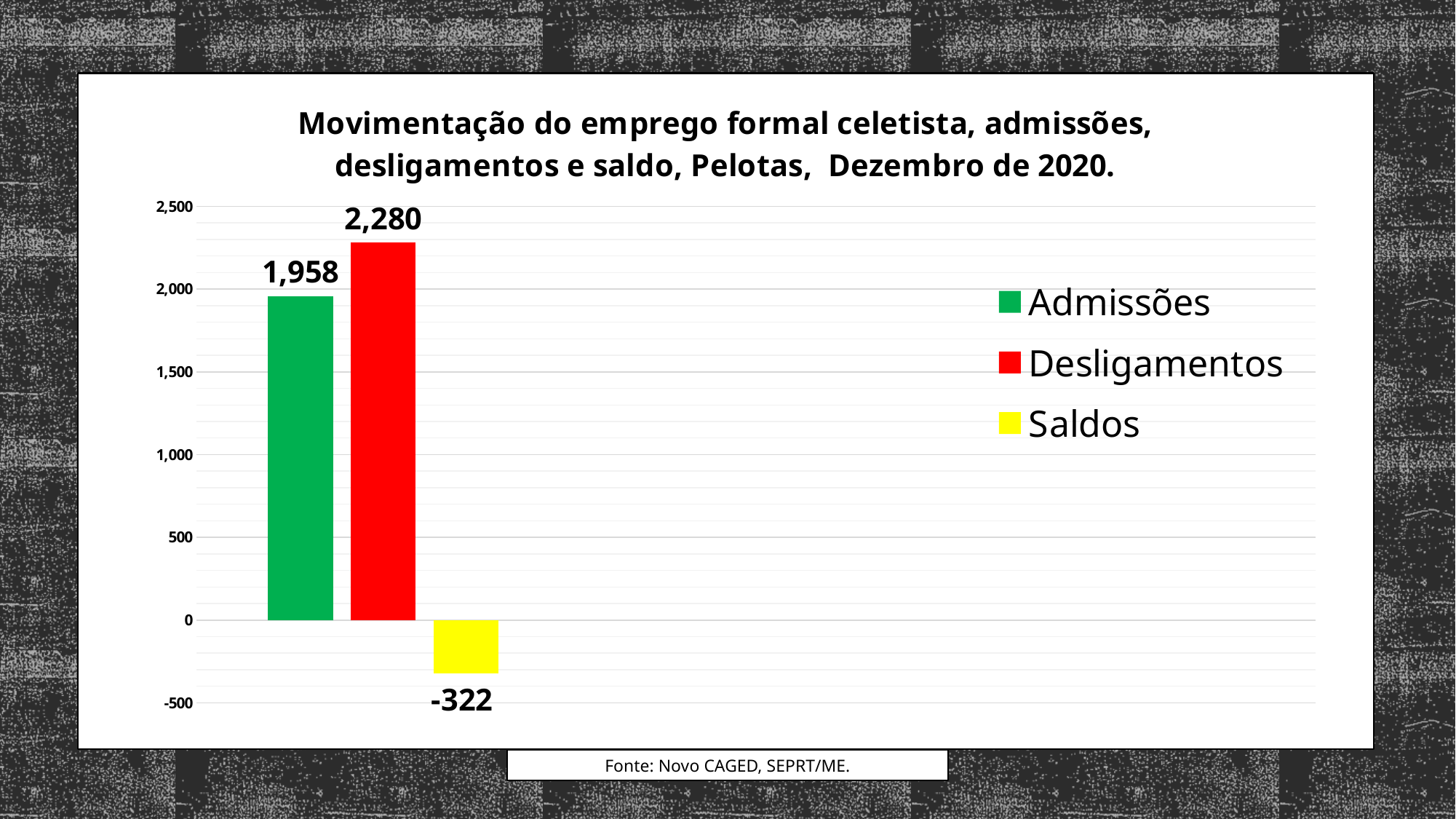
What kind of chart is shown? bar chart Which series has the highest value? Desligamentos How many series does the legend list? 3 How many bars are plotted in the chart? 3 What is the value for Saldos? -322 What colour is the Saldos bar? yellow What is the difference between Desligamentos and Admissões? 322 Which series has the lowest value? Saldos What is the value for Admissões? 1,958 What is the value for Desligamentos? 2,280 Is the value for Admissões greater or less than 2,000? less Which is larger, Admissões or Desligamentos? Desligamentos